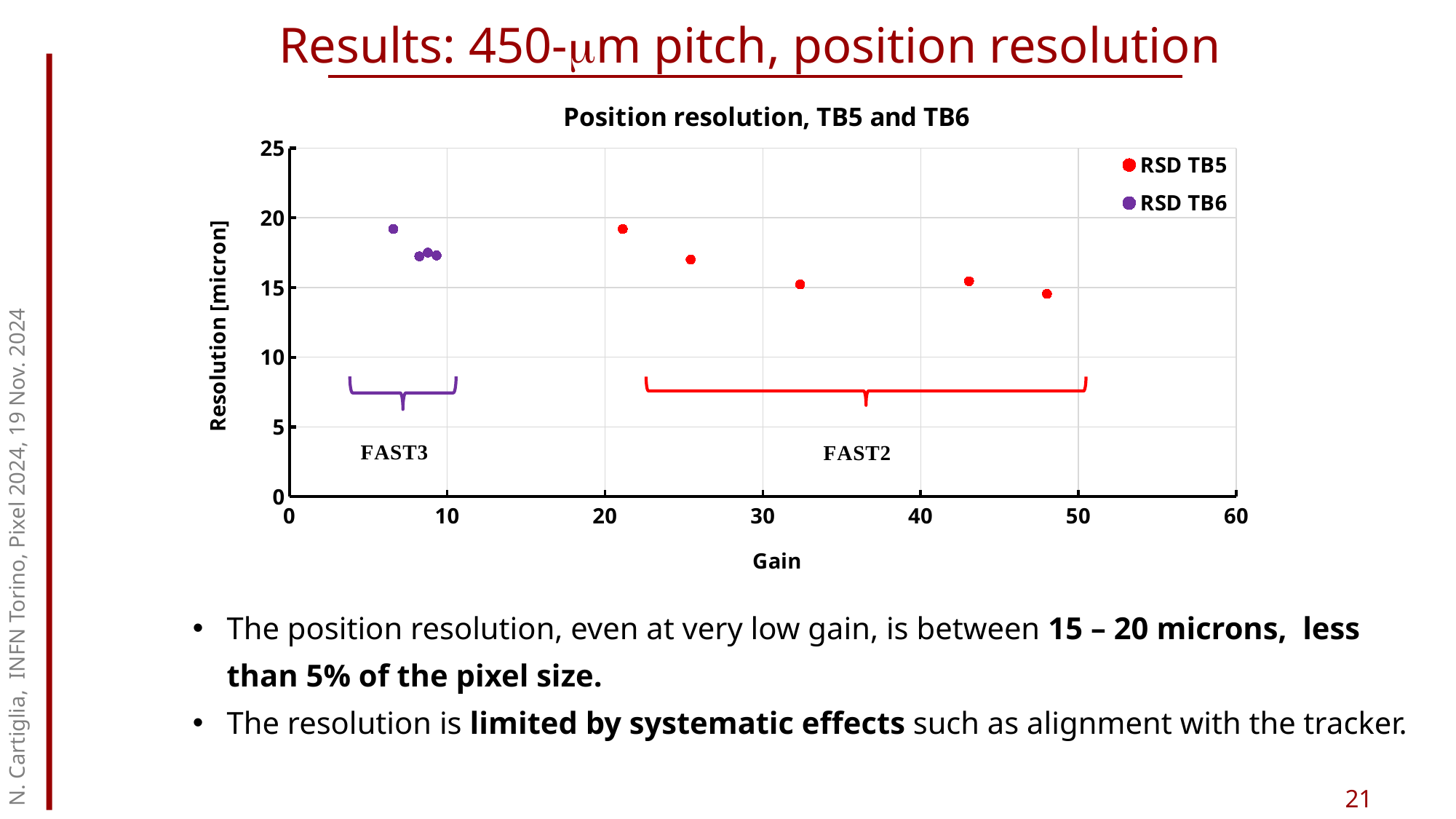
What is the label of the y axis? Resolution [micron] How many data points are plotted for the RSD TB5 series? 5 Does the resolution for RSD TB5 generally rise or fall as gain increases? fall Are all plotted resolution values greater or less than 20 microns? less Is the resolution for the RSD TB5 point at the highest gain (near 48) greater or less than 15? less Which series has its points at higher gain values, RSD TB5 or RSD TB6? RSD TB5 How many series does the legend list? 2 Which series contains the point with the lowest resolution? RSD TB5 How many data points are plotted for the RSD TB6 series? 4 Is the resolution for the RSD TB6 point at the lowest gain (near 6.5) greater or less than 15? greater What is the title of the chart? Position resolution, TB5 and TB6 What kind of chart is shown on the slide? Scatter plot